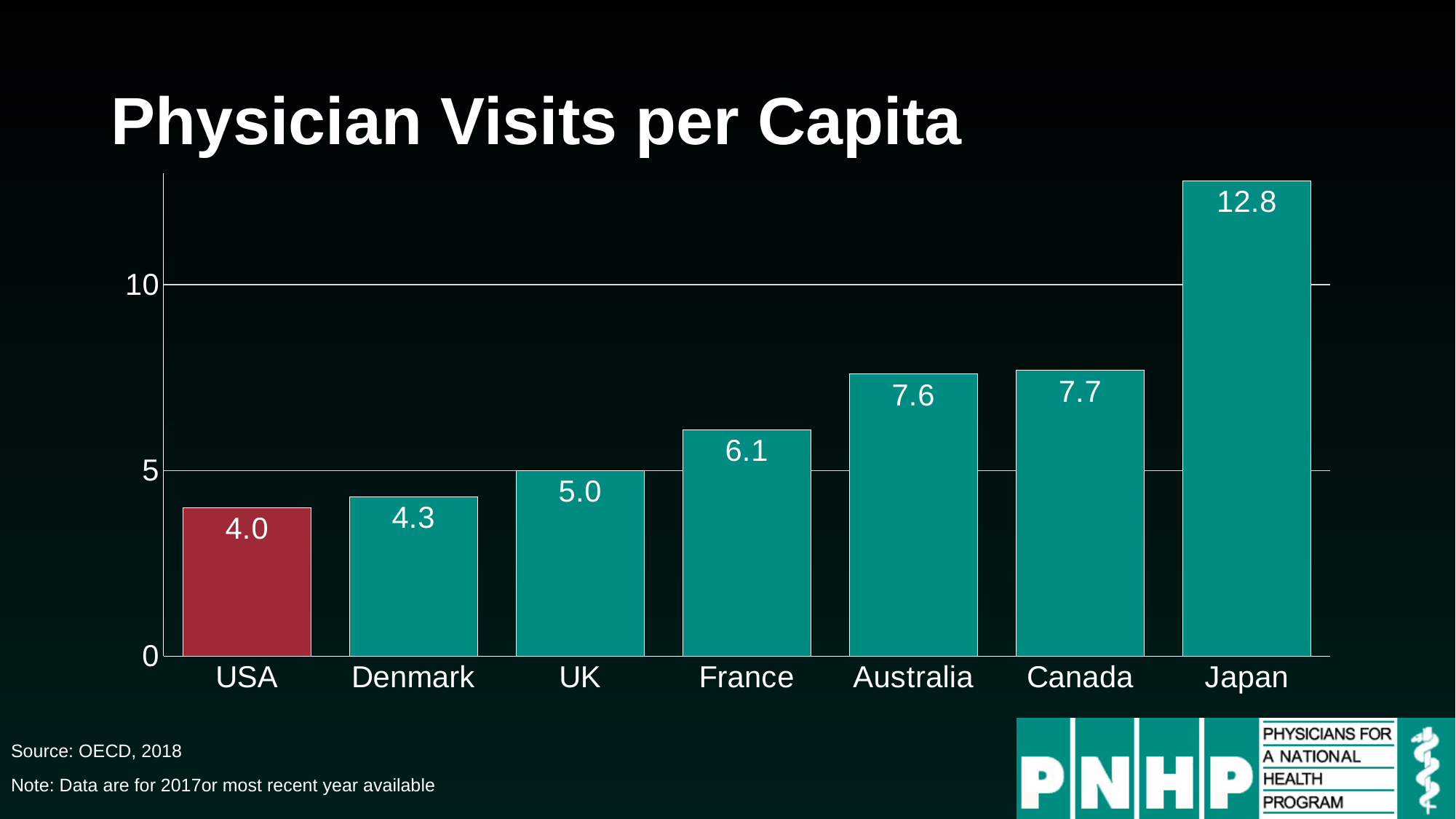
What is the value for the USA? 4.0 Which country's bar is coloured differently (red) from the others? USA Which is larger, the value for France or the value for Denmark? France Which country has the lowest physician visits per capita? USA What is the value for Japan? 12.8 How many countries are shown in the chart? 7 What is the difference between Australia's and Denmark's values? 3.3 What is the difference between Japan's and the USA's values? 8.8 Is the value for Canada greater or less than 5? greater Which country has the highest physician visits per capita? Japan What is the value for France? 6.1 What kind of chart is shown on the slide? Bar chart